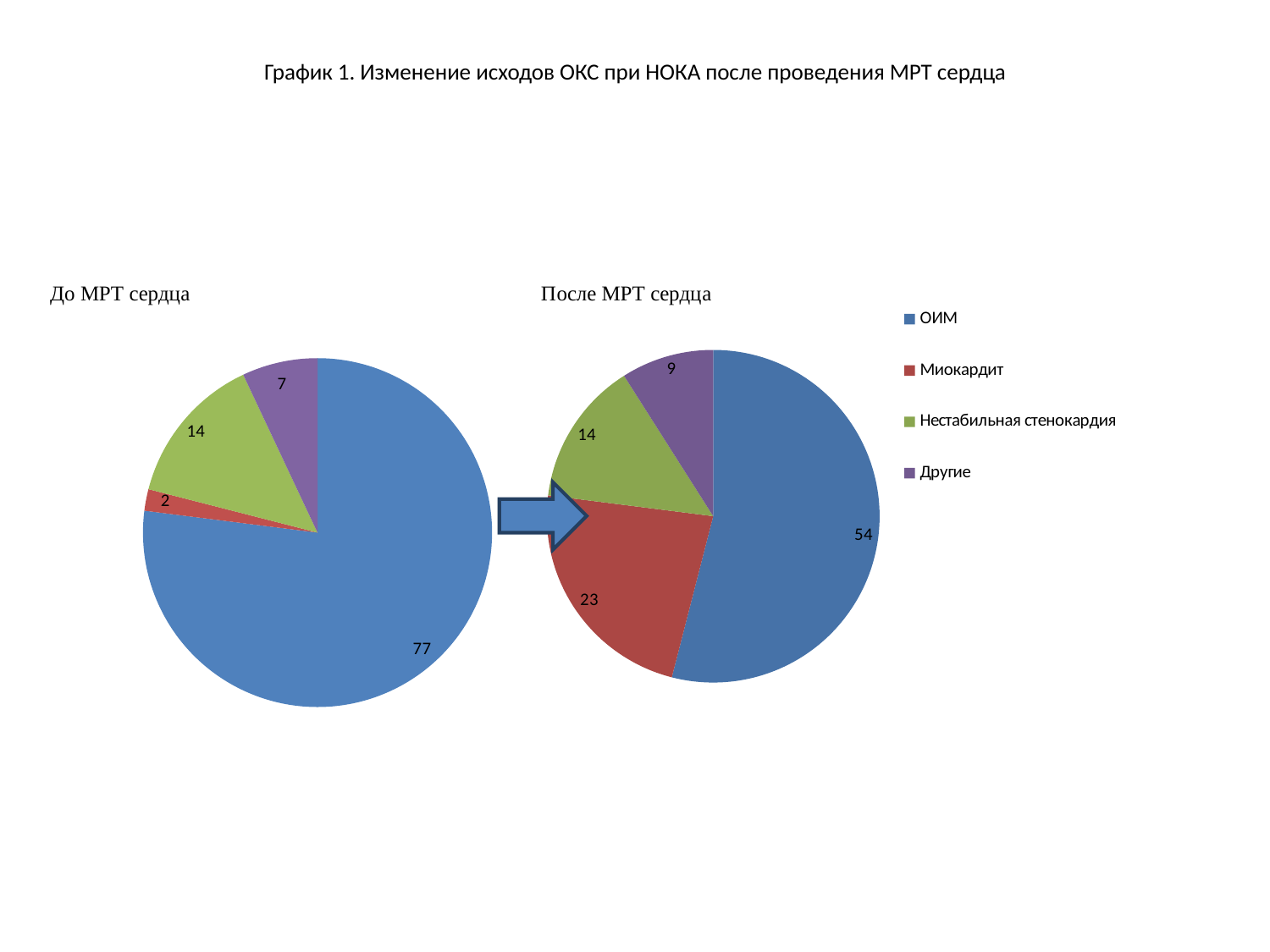
How many slices does the 'До МРТ сердца' pie chart have? 4 In the 'После МРТ сердца' pie chart, what is the value for Миокардит? 23 In the 'После МРТ сердца' pie chart, which is larger: Миокардит or Нестабильная стенокардия? Миокардит Which colour represents Нестабильная стенокардия in the legend? Green What type of chart is used on this slide? Pie chart What is the difference between the ОИМ value in the 'До МРТ сердца' chart and the ОИМ value in the 'После МРТ сердца' chart? 23 In the 'До МРТ сердца' pie chart, which category has the smallest slice? Миокардит In the 'До МРТ сердца' pie chart, what is the value for Другие? 7 In the 'До МРТ сердца' pie chart, what is the value for ОИМ? 77 In the 'После МРТ сердца' pie chart, which category has the largest slice? ОИМ How many entries does the legend list? 4 In the 'После МРТ сердца' pie chart, what share of the pie does ОИМ represent? 54%